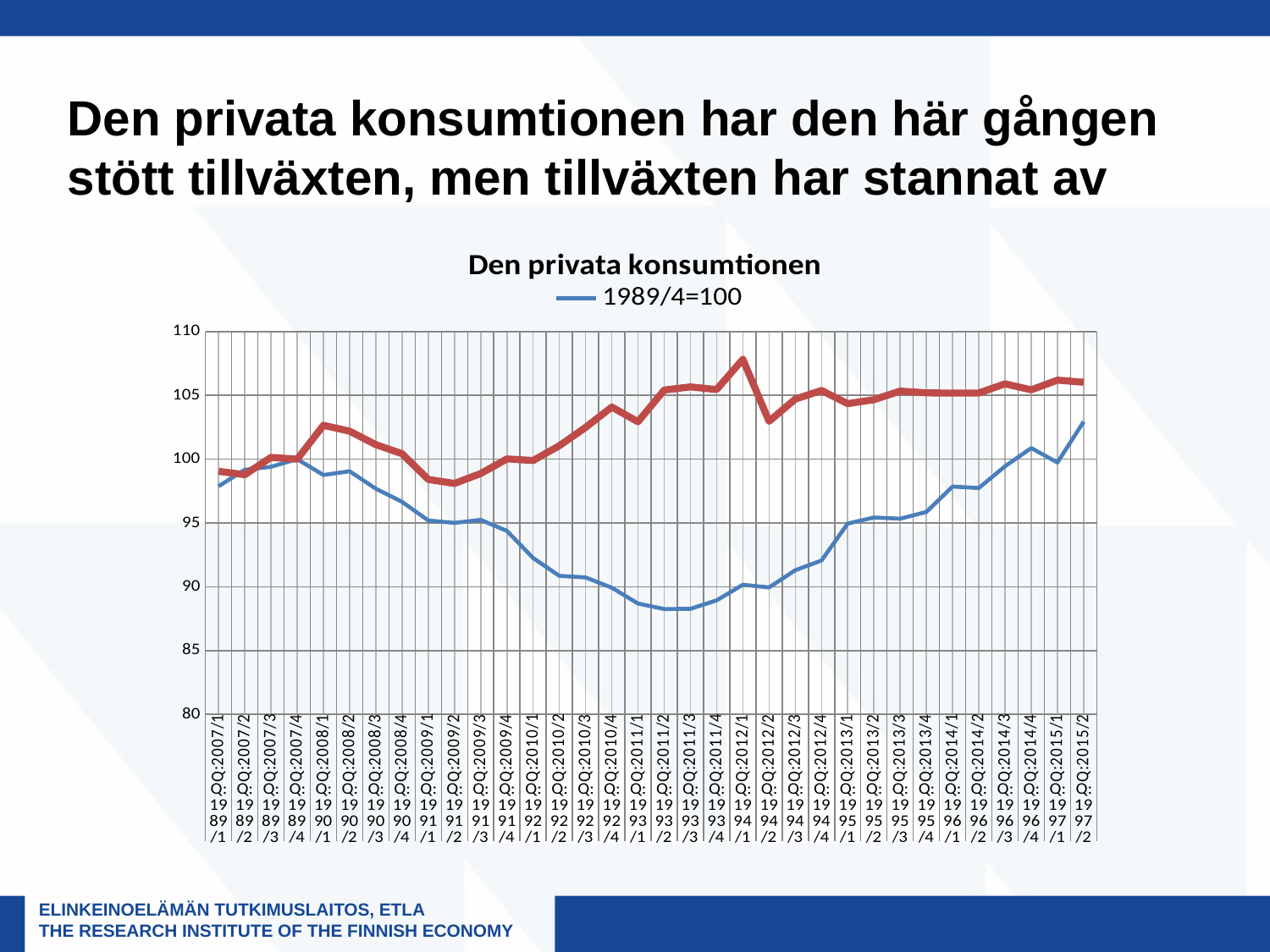
How many entries does the chart's legend list? 1 What kind of chart is shown on the slide? line chart Is the value of the red line at Q:2012/1 greater or less than 105? greater Does the blue line rise or fall between Q:2007/4 and Q:2011/2? fall At which quarter does the red line reach its highest value? Q:2012/1 Is the value of the blue line at Q:2015/2 greater or less than 100? greater Is the value of the red line at Q:2009/2 greater or less than 100? less How many quarterly points are plotted along the x axis, from Q:2007/1 to Q:2015/2? 34 What is the title of the chart? Den privata konsumtionen At Q:2011/2, which line is higher, the red line or the blue line? the red line What is the legend entry shown under the chart title? 1989/4=100